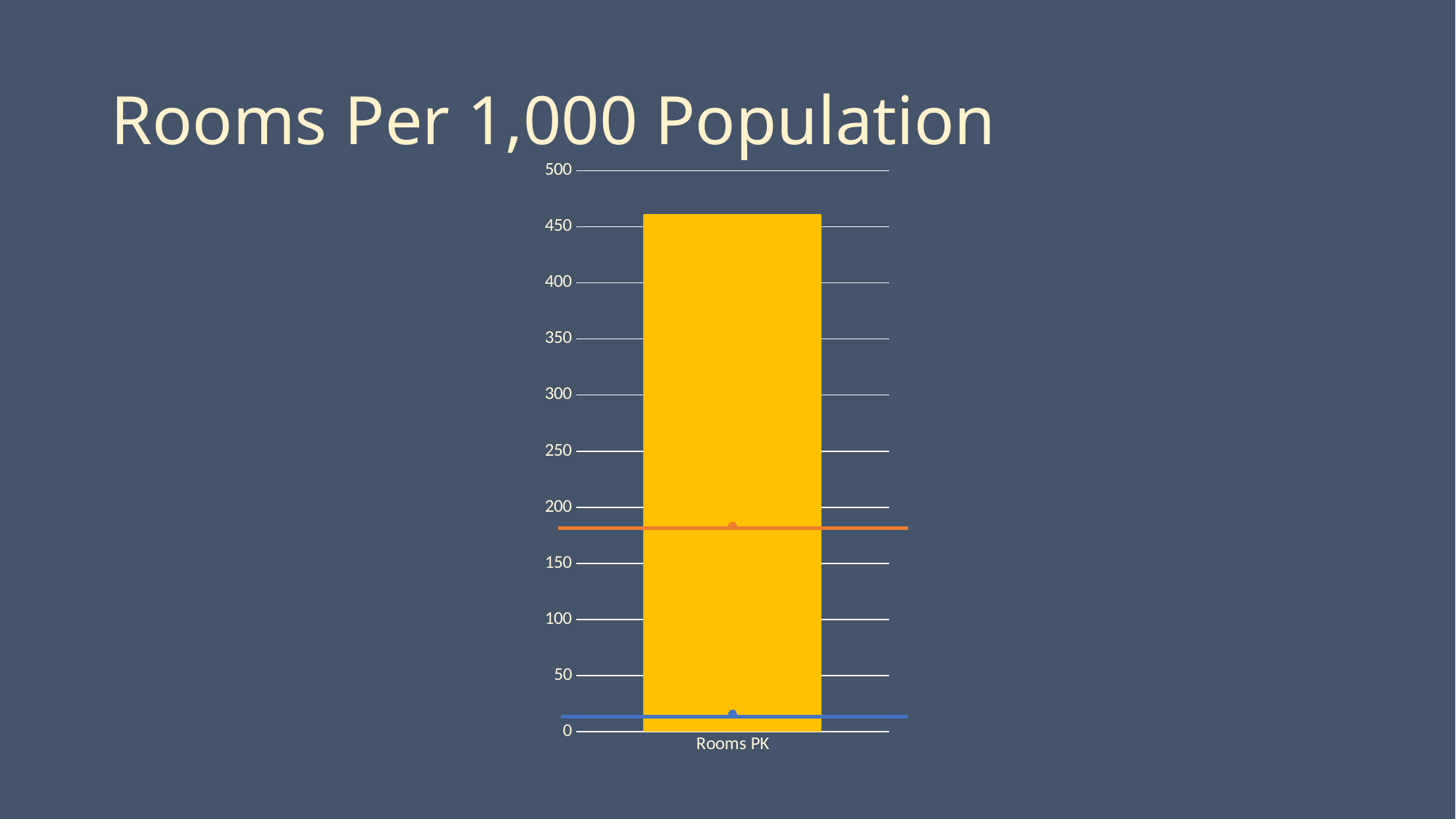
Is the value of the yellow bar for Rooms PK greater or less than 450? greater What kind of chart is shown on the slide? bar chart What is the label of the category on the x axis? Rooms PK Is the value of the yellow bar for Rooms PK greater or less than 400? greater Which is higher on the chart, the orange line or the blue line? the orange line Is the orange horizontal line on the chart greater or less than 200? less What is the title of the chart on the slide? Rooms Per 1,000 Population What is the highest value shown on the vertical axis of the chart? 500 How many categories are shown on the x axis of the chart? 1